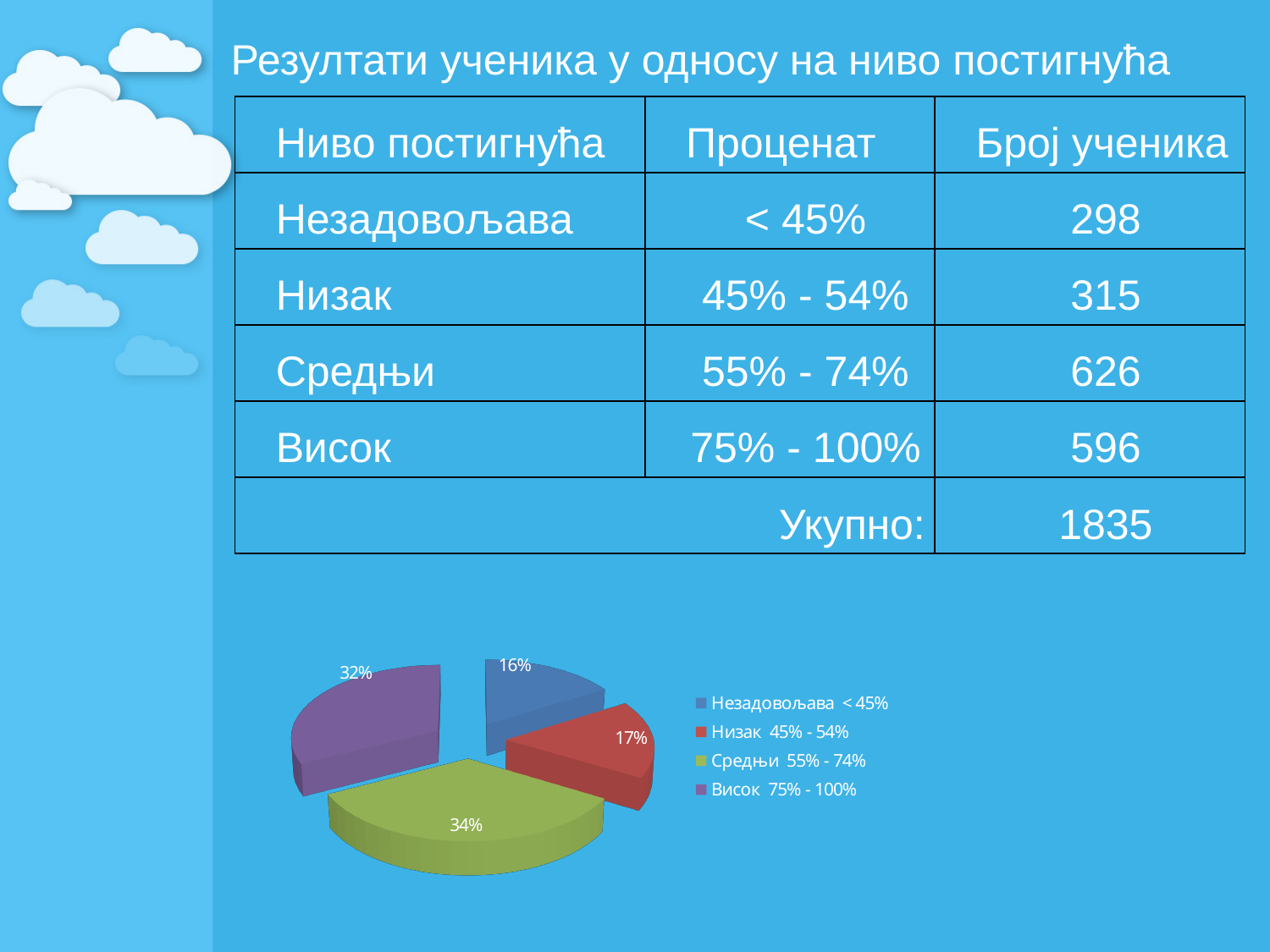
What is the value shown for the Висок 75% - 100% slice? 32% What colour is the Средњи 55% - 74% slice in the pie chart? green What is the difference in percentage points between the Средњи 55% - 74% slice and the Висок 75% - 100% slice? 2 What kind of chart is shown on the slide? pie chart What share of the pie does the Незадовољава < 45% slice represent? 16% What is the value shown for the Низак 45% - 54% slice? 17% Which category has the smallest slice of the pie? Незадовољава < 45% What share of the pie does the Средњи 55% - 74% slice represent? 34% How many slices does the pie chart have? 4 Which slice is larger: Низак 45% - 54% or Незадовољава < 45%? Низак 45% - 54% How many entries does the legend of the pie chart list? 4 Which category has the largest slice of the pie? Средњи 55% - 74%